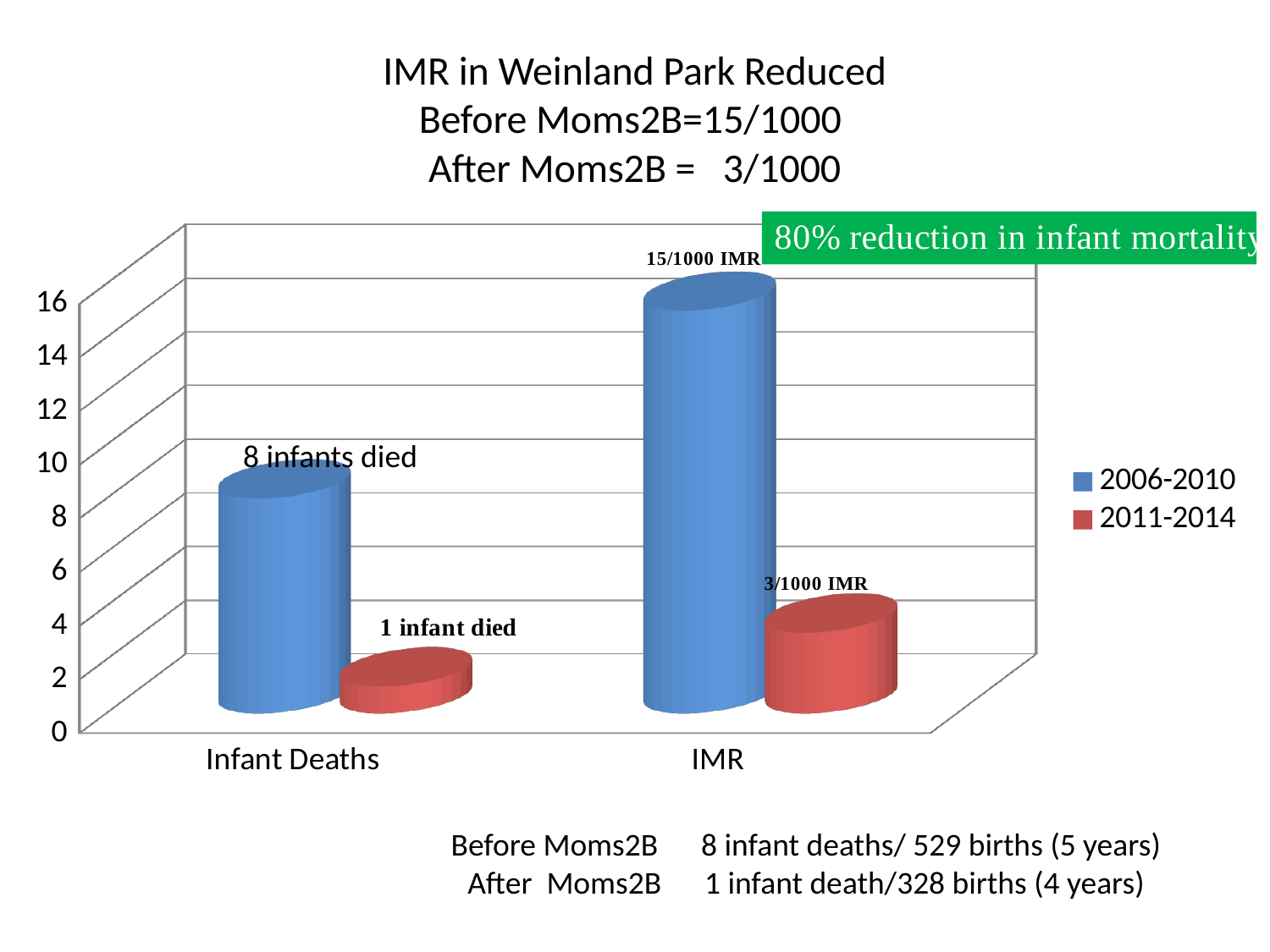
What kind of chart is shown on the slide? bar chart Which is larger for IMR: the 2006-2010 value or the 2011-2014 value? 2006-2010 What is the data label on the 2011-2014 bar for Infant Deaths? 1 infant died How many series does the legend list? 2 By how many infant deaths did the 2006-2010 value exceed the 2011-2014 value in the Infant Deaths category? 7 What is the data label on the 2006-2010 bar for Infant Deaths? 8 infants died How many categories are shown on the x axis? 2 What is the data label on the 2006-2010 bar for IMR? 15/1000 IMR What are the two series names listed in the legend? 2006-2010 and 2011-2014 What is the data label on the 2011-2014 bar for IMR? 3/1000 IMR Which bar is the shortest in the chart? Infant Deaths, 2011-2014 Which bar is the tallest in the chart? IMR, 2006-2010